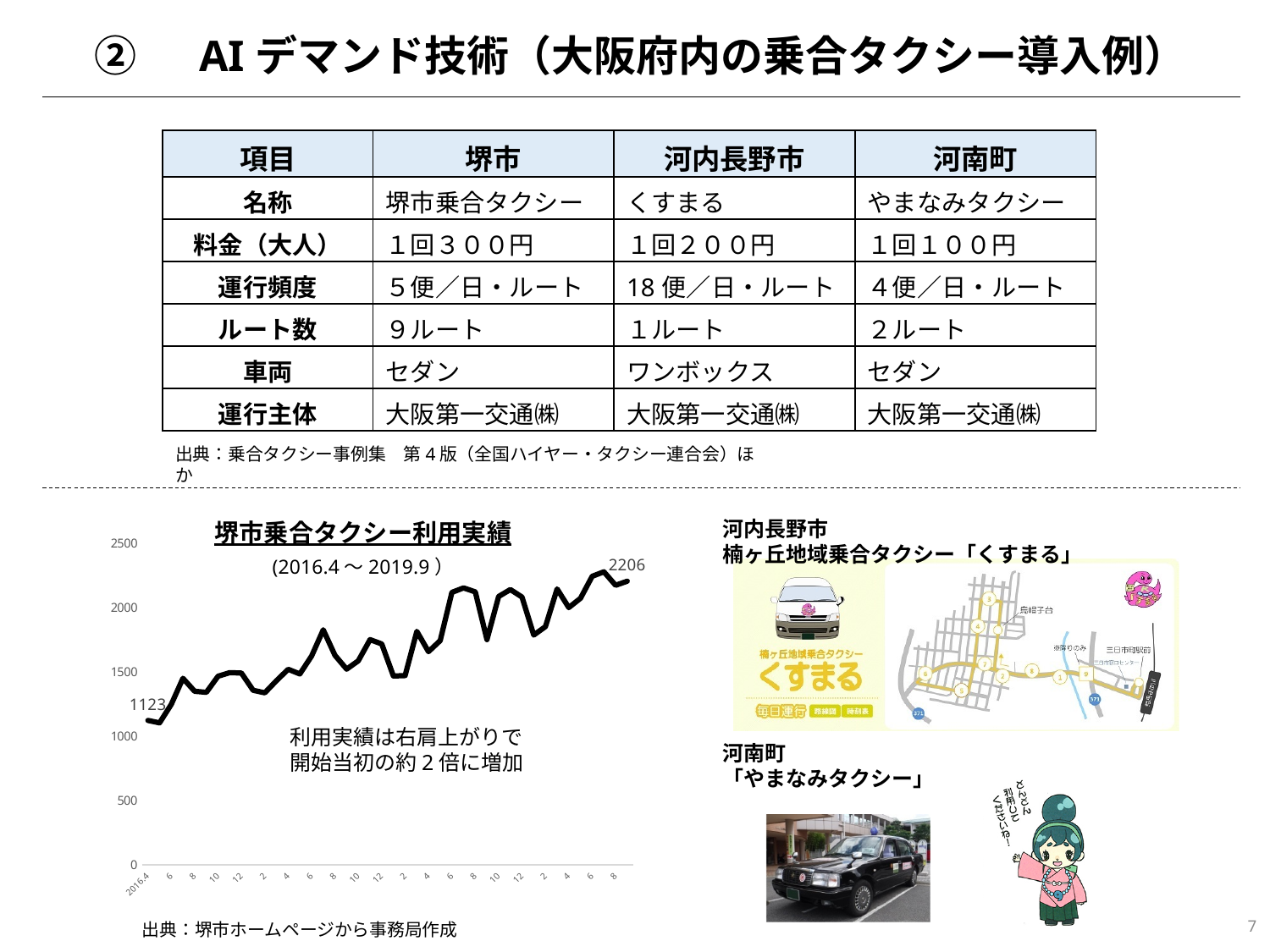
In the 堺市乗合タクシー利用実績 chart, do the values generally rise or fall from left to right along the x axis? rise What kind of chart is the 堺市乗合タクシー利用実績 chart? line chart What is the highest tick value shown on the y axis of the 堺市乗合タクシー利用実績 chart? 2500 In the 堺市乗合タクシー利用実績 chart, what is the difference between the final labelled value (2206) and the initial labelled value (1123)? 1083 In the 堺市乗合タクシー利用実績 chart, which is larger: the value at the start of the series or the value at the end? the value at the end (2206) In the 堺市乗合タクシー利用実績 chart, is the final value of the series greater or less than 2000? greater In the 堺市乗合タクシー利用実績 chart, what is the value labelled at the end of the series? 2206 In the 堺市乗合タクシー利用実績 chart, what is the value labelled at the start of the series (2016.4)? 1123 What period does the 堺市乗合タクシー利用実績 chart cover, according to its subtitle? 2016.4～2019.9 In the 堺市乗合タクシー利用実績 chart, is the value at 2016.4 greater or less than 1500? less